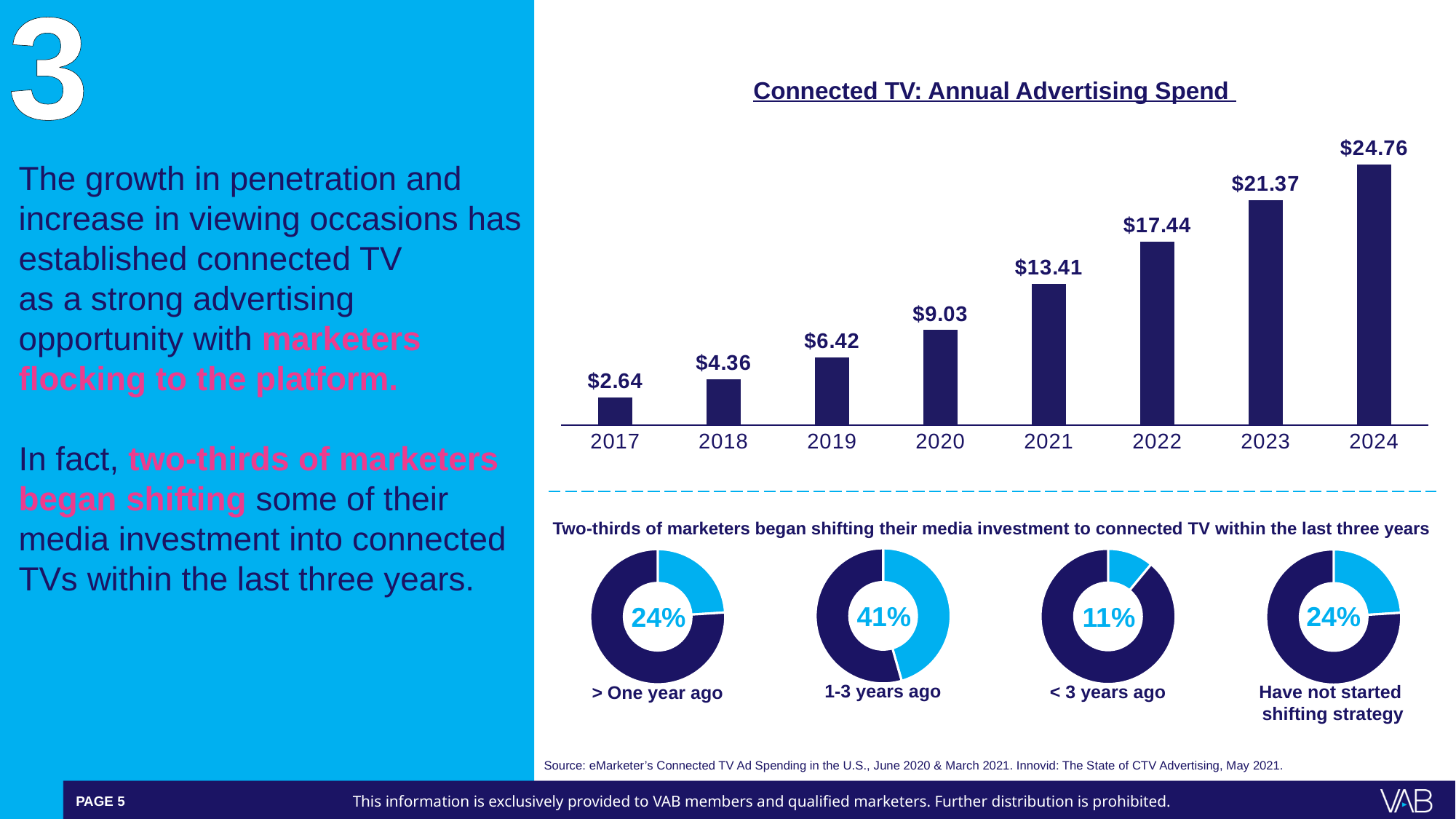
In the 'Connected TV: Annual Advertising Spend' chart, which is larger, the value for 2019 or the value for 2021? 2021 In the 'Connected TV: Annual Advertising Spend' chart, what is the value for 2017? $2.64 In the 'Connected TV: Annual Advertising Spend' chart, what is the difference between the 2023 and 2022 values? $3.93 In the 'Connected TV: Annual Advertising Spend' chart, what is the value for 2020? $9.03 In the 'Connected TV: Annual Advertising Spend' chart, do the values rise or fall from 2017 to 2024? Rise In the 'Connected TV: Annual Advertising Spend' chart, which year has the highest value? 2024 What kind of chart is 'Connected TV: Annual Advertising Spend'? Bar chart In the 'Connected TV: Annual Advertising Spend' chart, which year has the lowest value? 2017 In the 'Connected TV: Annual Advertising Spend' chart, what is the difference between the 2024 and 2017 values? $22.12 In the donut charts at the bottom of the slide, what percentage is shown for '< 3 years ago'? 11% In the donut charts at the bottom of the slide, what percentage is shown for '1-3 years ago'? 41% How many years are shown in the 'Connected TV: Annual Advertising Spend' chart? 8